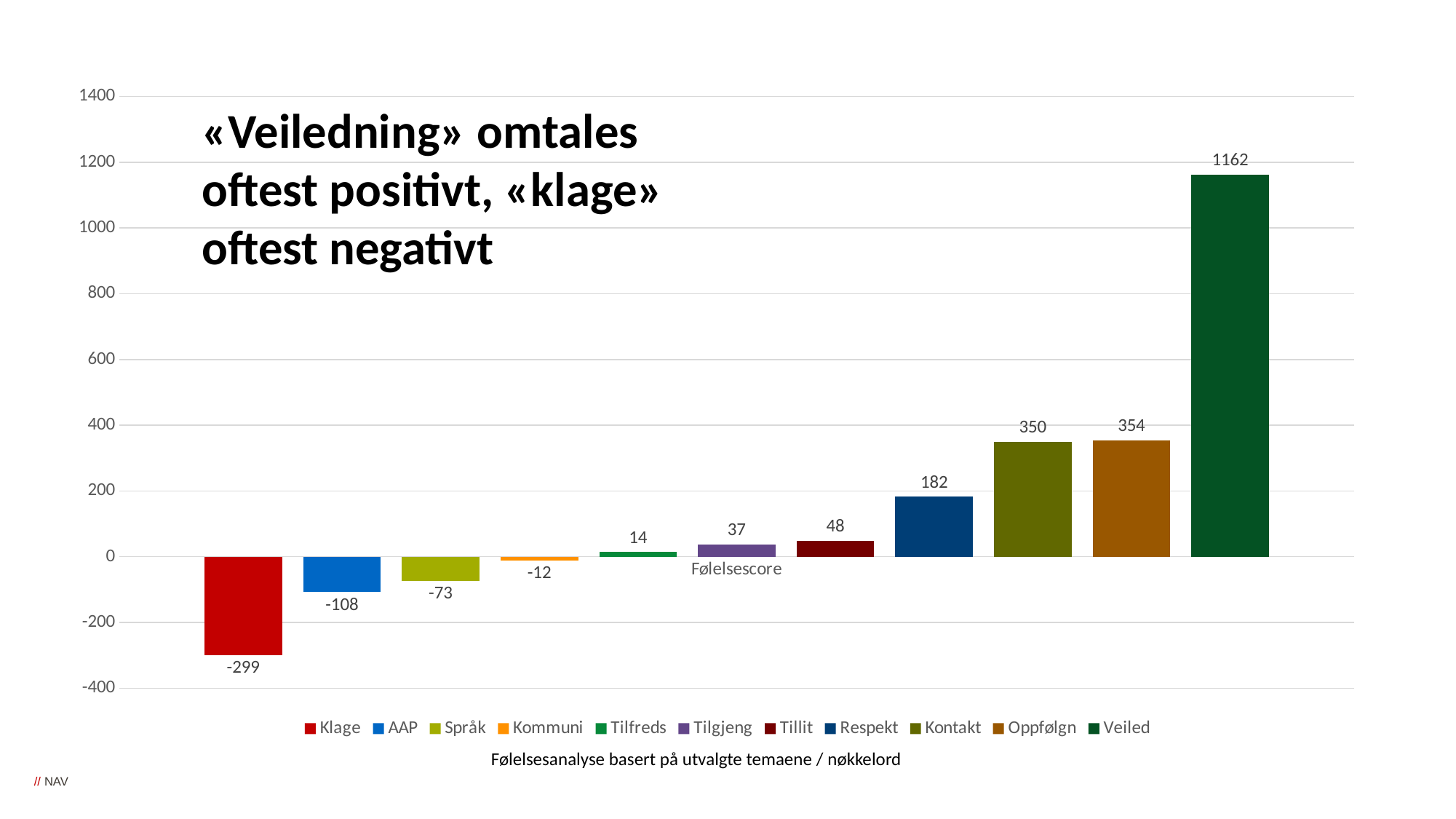
What is the value for Klage? -299 How many categories are shown in the chart? 11 What is the difference between the values for Veiled and Oppfølgn? 808 What is the value for Kommuni? -12 What is the value for Veiled? 1162 What kind of chart is shown on the slide? Bar chart Which is larger, the value for Tillit or the value for Tilgjeng? Tillit Do the values rise or fall from left to right along the x axis? Rise Which category has the lowest value? Klage Which category has the highest value? Veiled What is the difference between the values for Oppfølgn and Kontakt? 4 What is the value for Respekt? 182